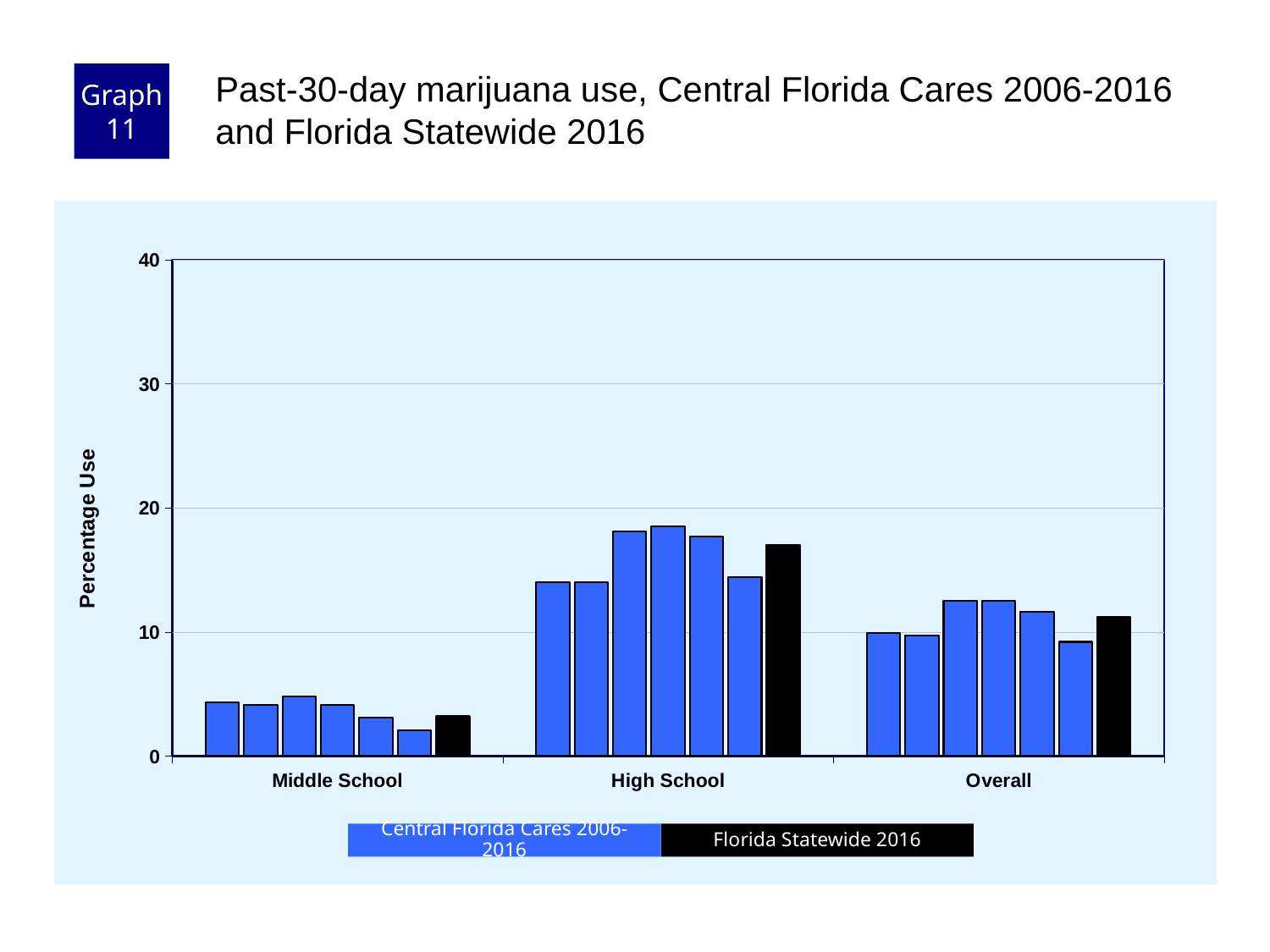
Which category has the lowest values? Middle School What is the label on the y axis? Percentage Use Which is larger, the Florida Statewide 2016 value for High School or for Middle School? High School What kind of chart is shown on the slide? bar chart Is the Florida Statewide 2016 value for High School greater or less than 20? less Is the Florida Statewide 2016 value for Overall greater or less than 20? less Is the Florida Statewide 2016 value for High School greater or less than 10? greater Which is larger, the Florida Statewide 2016 value for Overall or for Middle School? Overall Which category has the highest values? High School How many series does the legend list? 2 How many categories are shown on the x axis? 3